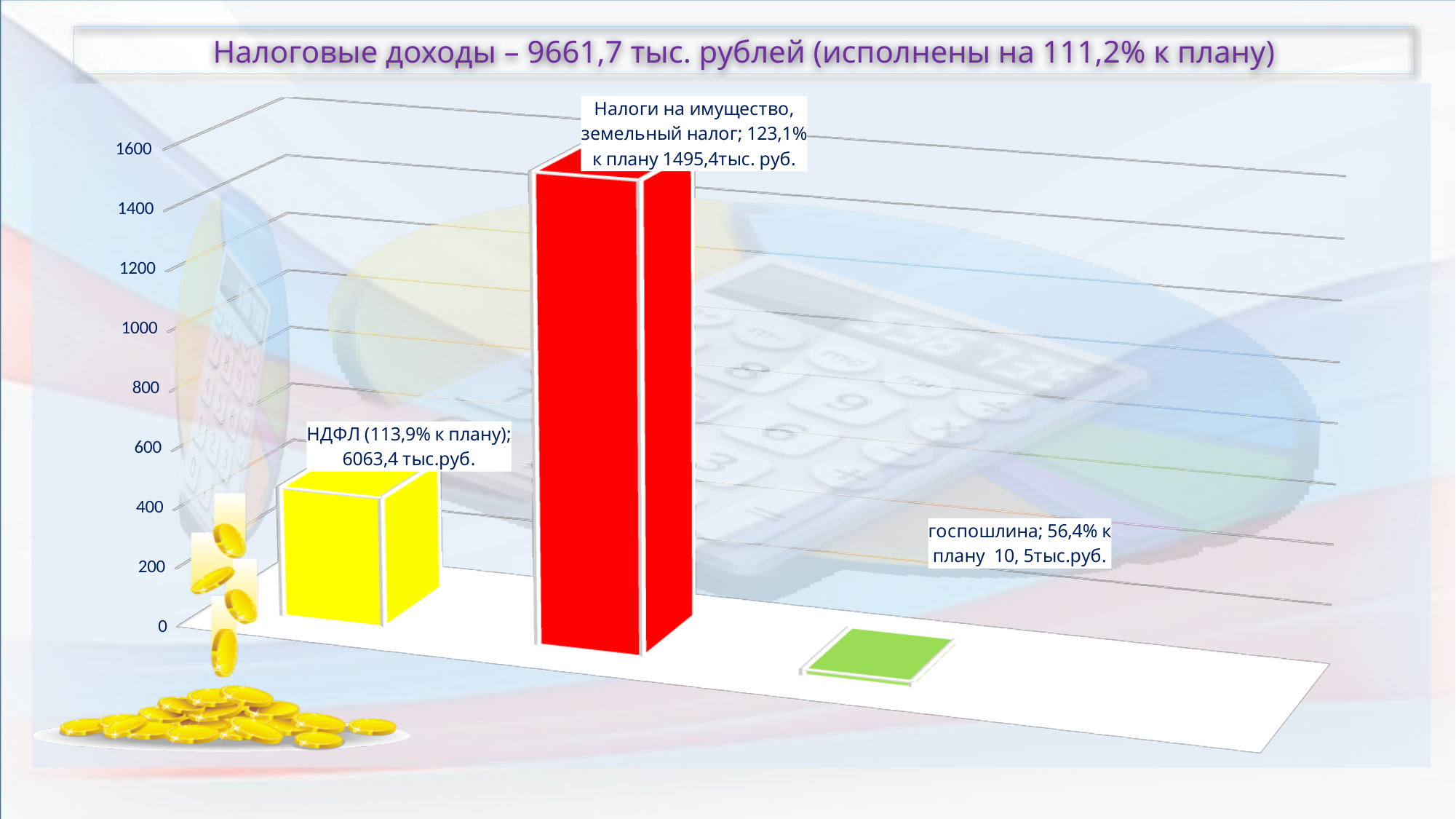
What percentage of plan is shown for НДФЛ? 113,9% Which category has the lowest value on the chart? госпошлина What value is printed for the госпошлина bar? 10, 5тыс.руб. What percentage of plan is shown for Налоги на имущество, земельный налог? 123,1% What percentage of plan is shown for госпошлина? 56,4% How many bars are plotted on the chart? 3 What value is printed for the Налоги на имущество, земельный налог bar? 1495,4тыс. руб. Which is larger: the value for Налоги на имущество, земельный налог or the value for госпошлина? Налоги на имущество, земельный налог Is the bar for Налоги на имущество, земельный налог greater or less than 1400 on the axis? greater What is the difference between the printed values for Налоги на имущество, земельный налог and госпошлина? 1484,9 тыс. руб. What value is printed in the data label for НДФЛ? 6063,4 тыс.руб. What kind of chart is shown on the slide? bar chart